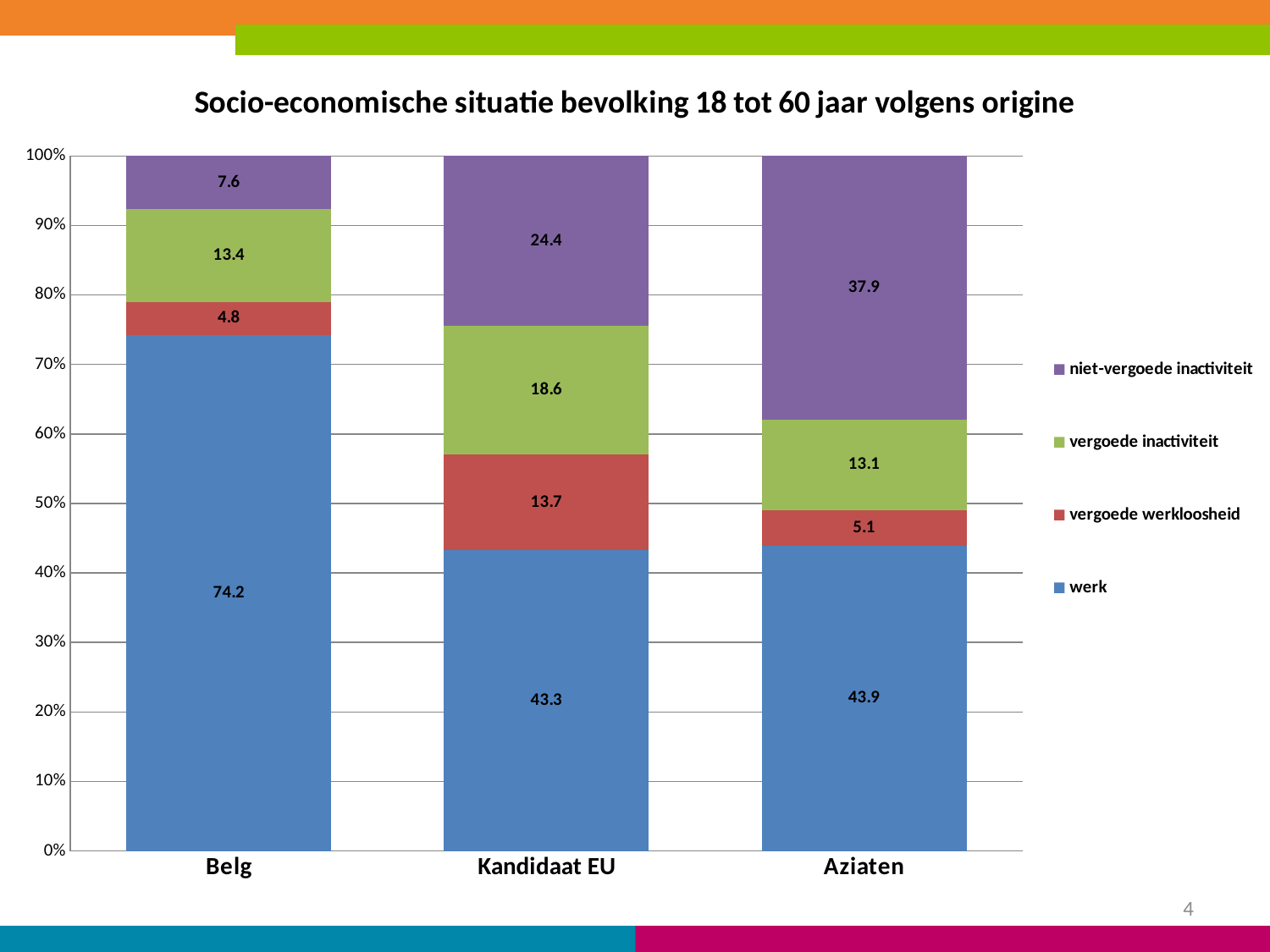
How many series does the legend list? 4 What is the value for 'vergoede inactiviteit' for Kandidaat EU? 18.6 Which is larger: 'niet-vergoede inactiviteit' for Kandidaat EU or for Aziaten? Aziaten Which category has the highest value for 'werk'? Belg What is the title of the chart? Socio-economische situatie bevolking 18 tot 60 jaar volgens origine What kind of chart is shown on the slide? Stacked bar chart What is the value for 'niet-vergoede inactiviteit' for Aziaten? 37.9 What is the difference between the 'werk' values for Belg and Kandidaat EU? 30.9 How many categories are shown on the x axis? 3 Which category has the lowest value for 'vergoede werkloosheid'? Belg What is the value for 'werk' for Belg? 74.2 What is the value for 'vergoede werkloosheid' for Kandidaat EU? 13.7